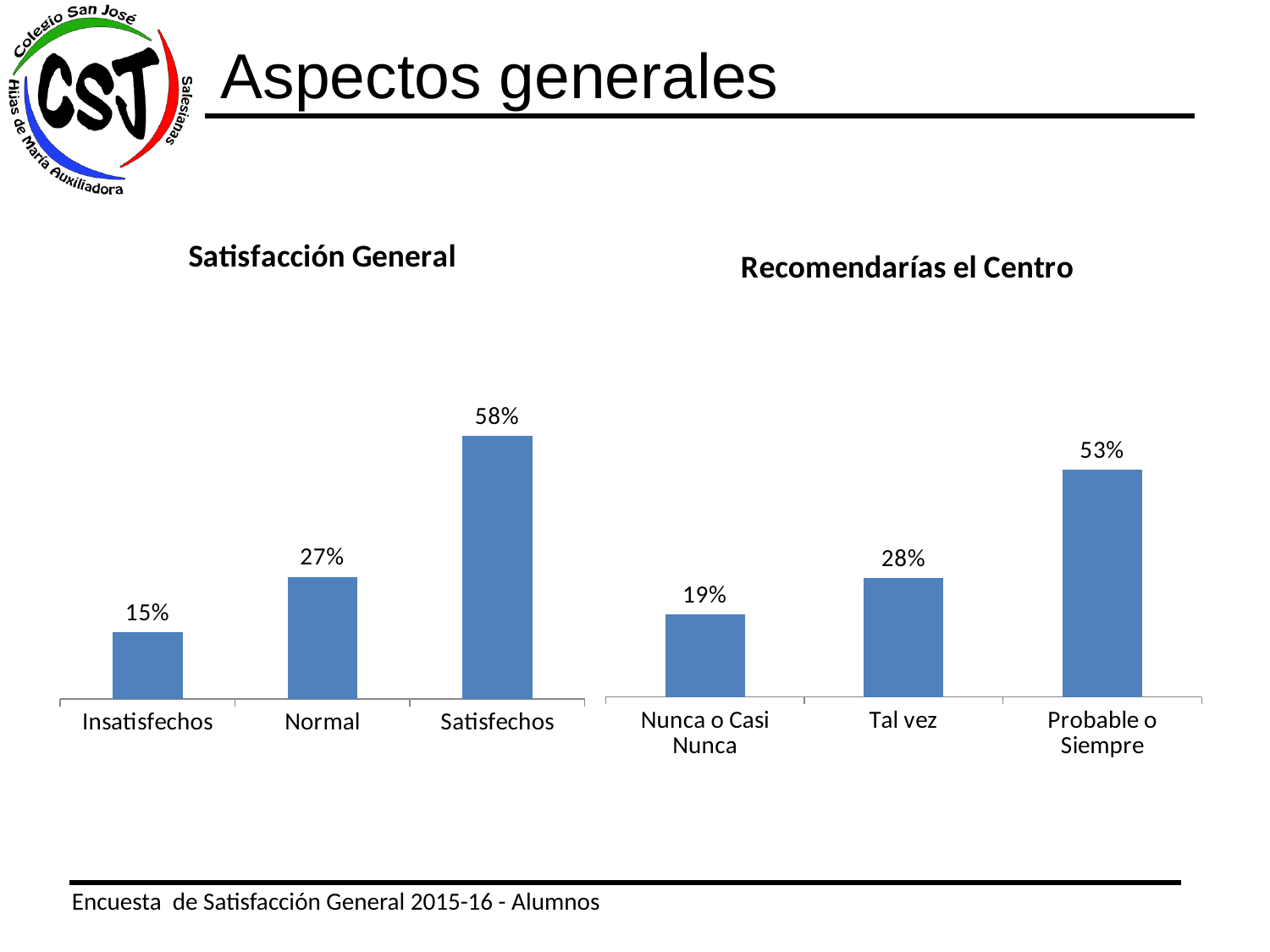
In the 'Satisfacción General' chart, what is the value for Insatisfechos? 15% In the 'Recomendarías el Centro' chart, what is the value for Tal vez? 28% In the 'Satisfacción General' chart, which category has the highest value? Satisfechos How many categories are shown in the 'Recomendarías el Centro' chart? 3 In the 'Satisfacción General' chart, what is the difference between Satisfechos and Normal? 31% In the 'Recomendarías el Centro' chart, what is the value for Nunca o Casi Nunca? 19% In the 'Satisfacción General' chart, what is the value for Satisfechos? 58% In the 'Satisfacción General' chart, which is larger: Normal or Insatisfechos? Normal What type of chart is the 'Satisfacción General' chart? Bar chart In the 'Recomendarías el Centro' chart, what is the difference between Probable o Siempre and Tal vez? 25% In the 'Recomendarías el Centro' chart, do the values rise or fall from left to right? Rise In the 'Recomendarías el Centro' chart, which category has the lowest value? Nunca o Casi Nunca